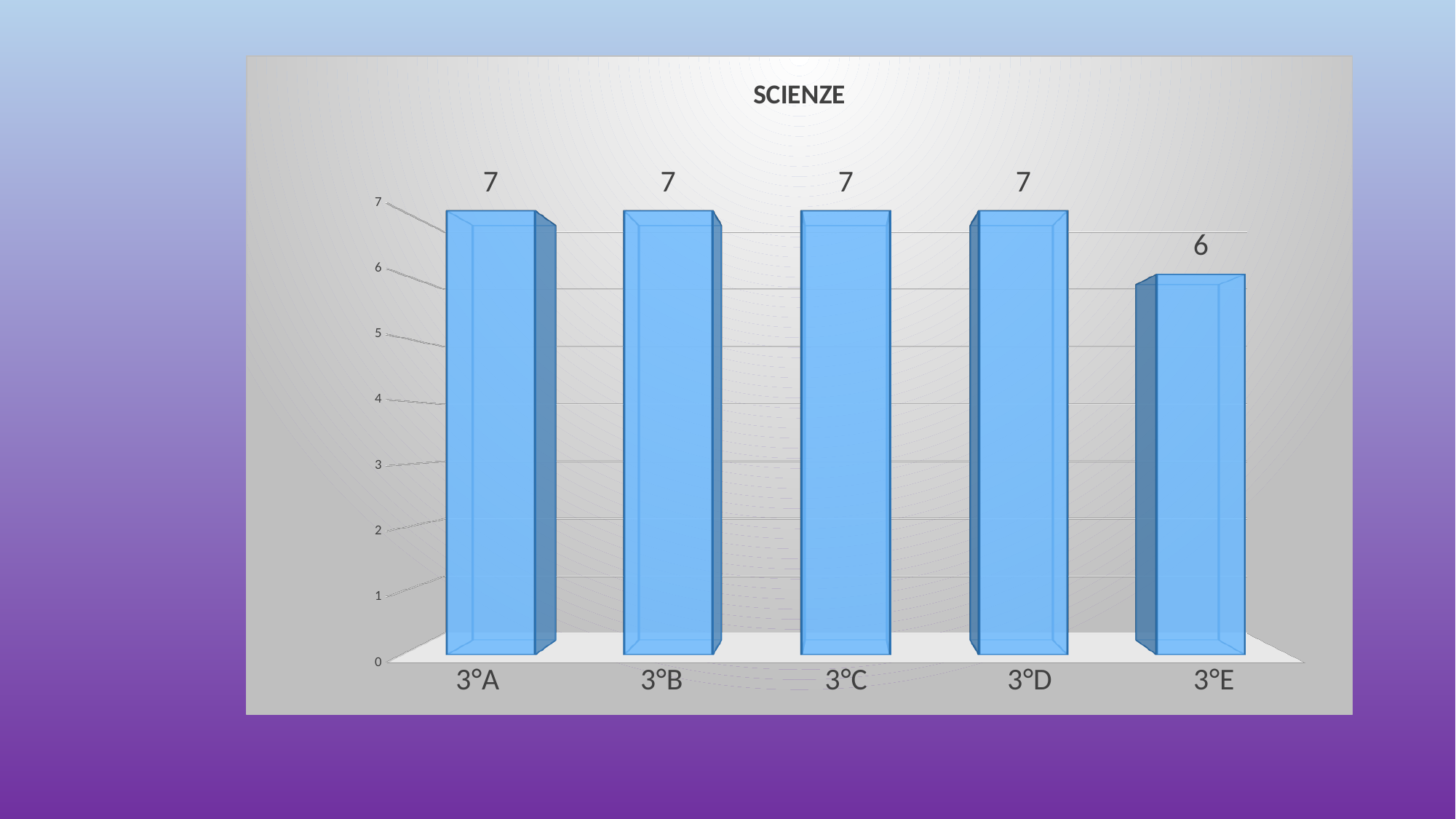
How many categories are shown in the SCIENZE chart? 5 Is the value for 3°E greater or less than 5? greater What is the value for 3°C in the SCIENZE chart? 7 What is the value for 3°A in the SCIENZE chart? 7 Which category has the lowest value in the SCIENZE chart? 3°E What is the difference between the values for 3°D and 3°E? 1 What kind of chart is shown on the slide? bar chart What is the title of the chart? SCIENZE How many categories have a value of 7 in the SCIENZE chart? 4 Which is larger, the value for 3°B or the value for 3°E? 3°B What is the highest value shown on the vertical axis of the SCIENZE chart? 7 What is the value for 3°E in the SCIENZE chart? 6